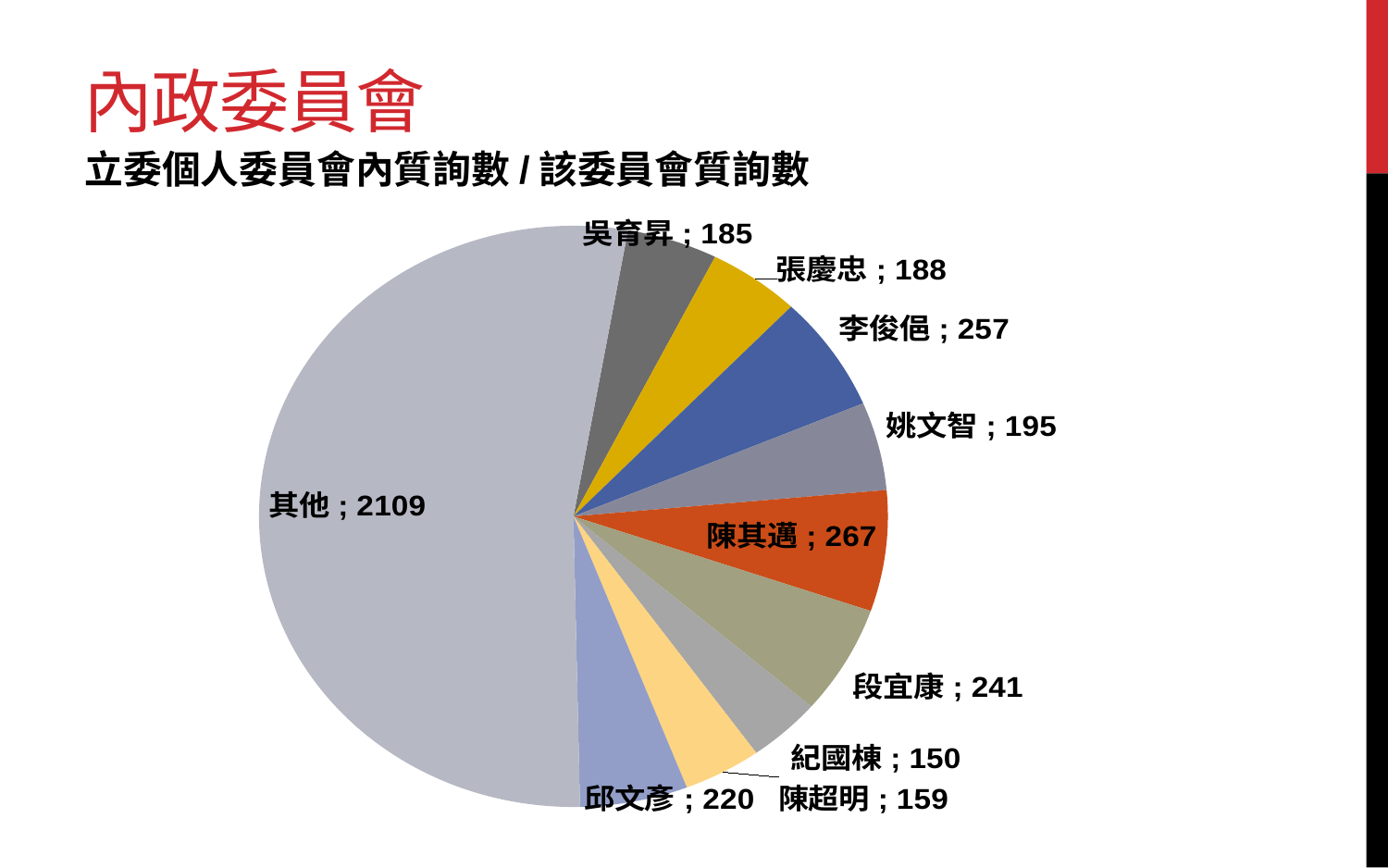
What is the value for 邱文彥? 220 Which slice of the pie is the largest? 其他 How many slices does the pie chart have? 10 What is the value for 紀國棟? 150 What is the value for 陳其邁? 267 Excluding 其他, which legislator has the highest value? 陳其邁 Which is larger, the value for 段宜康 or the value for 邱文彥? 段宜康 What is the difference between the values for 陳其邁 and 李俊俋? 10 What is the difference between the values for 邱文彥 and 陳超明? 61 What is the value for 其他? 2109 Which slice of the pie is the smallest? 紀國棟 What kind of chart is shown on the slide? pie chart